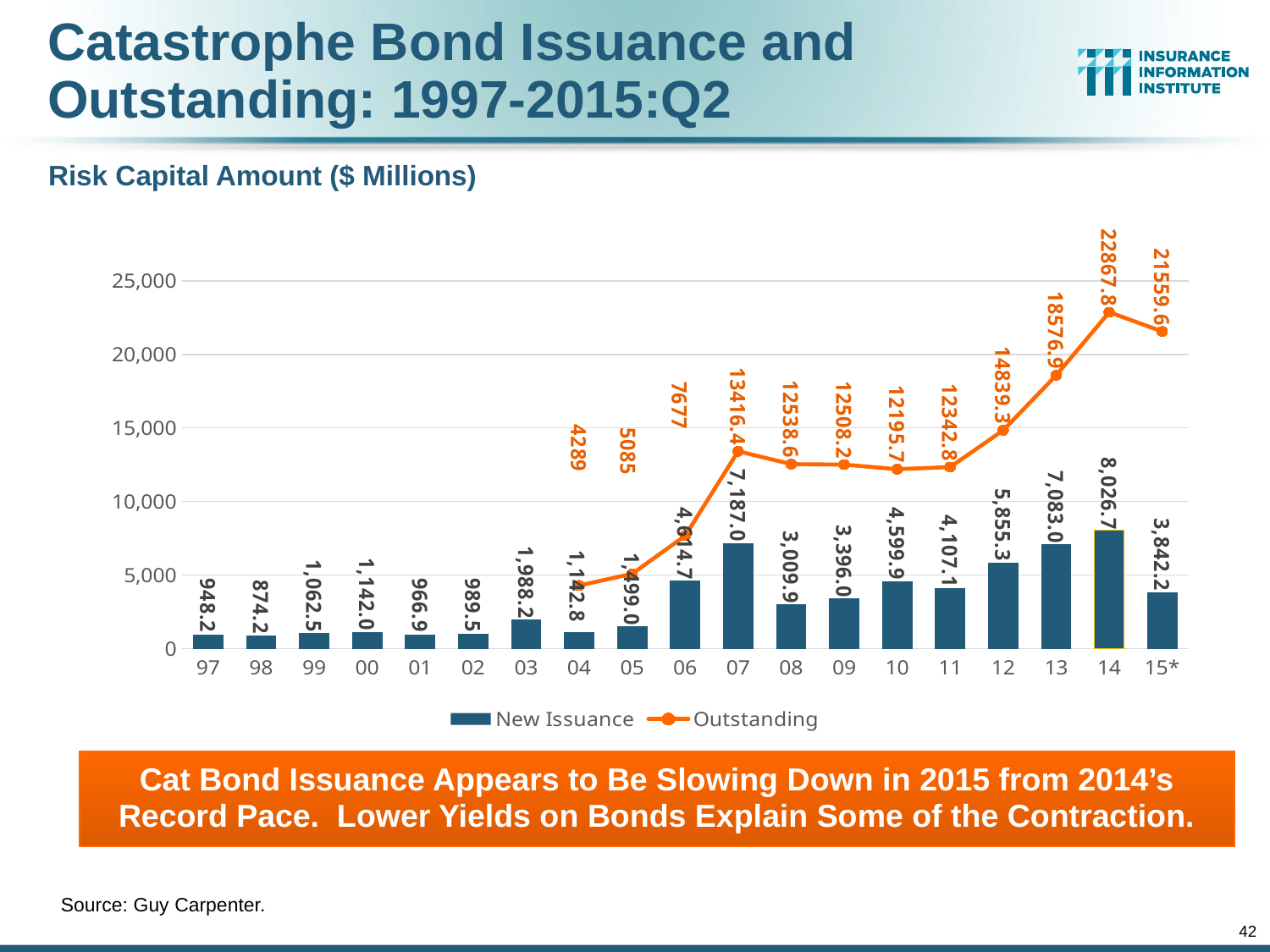
Is the Outstanding value for 13 greater or less than 15,000? greater How many years are shown on the x axis? 19 How many series does the legend list? 2 What is the difference between the New Issuance values for 14 and 15*? 4,184.5 Which has the larger Outstanding value, 07 or 08? 07 What is the Outstanding value for 14? 22867.8 What kind of chart is shown on the slide? Combination bar and line chart What is the New Issuance value for 14? 8,026.7 Which year has the lowest New Issuance value? 98 What is the Outstanding value for 04? 4289 What is the difference between the Outstanding values for 14 and 13? 4290.9 Which year has the highest New Issuance value? 14